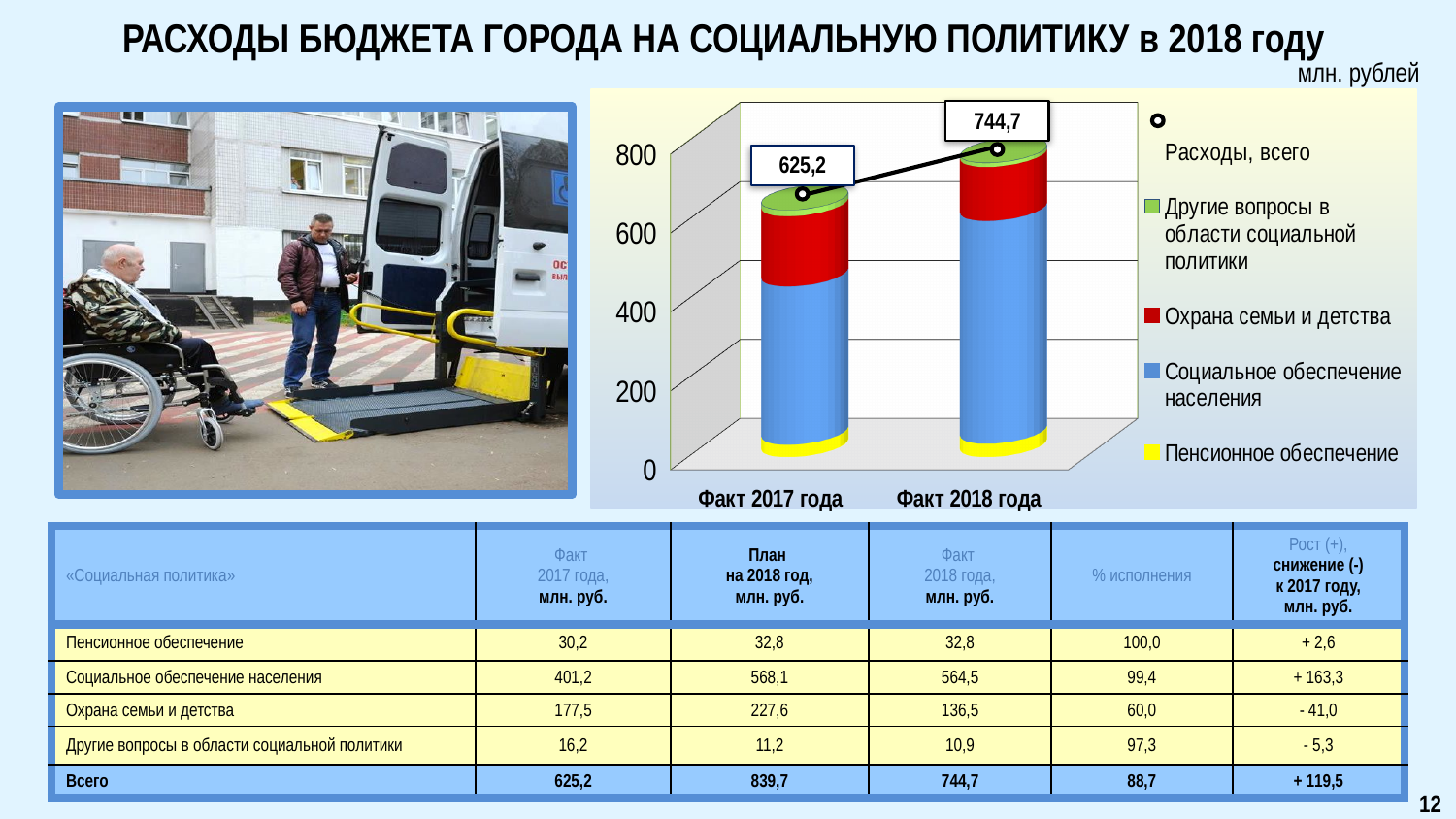
What kind of chart is shown on the slide? Stacked bar chart What is the value of the 'Расходы, всего' data label for Факт 2018 года? 744,7 Do the total expenditures rise or fall from Факт 2017 года to Факт 2018 года? Rise Which legend entry is shown in red? Охрана семьи и детства What is the value of the 'Расходы, всего' data label for Факт 2017 года? 625,2 What unit is stated for the chart values? млн. рублей Which category has the higher total expenditure, Факт 2017 года or Факт 2018 года? Факт 2018 года How many categories are shown on the x axis of the chart? 2 Is the total value for Факт 2017 года greater or less than 600? greater Is the total value for Факт 2018 года greater or less than 800? less What is the difference between the total for Факт 2018 года and the total for Факт 2017 года? 119,5 How many entries does the chart legend list? 5